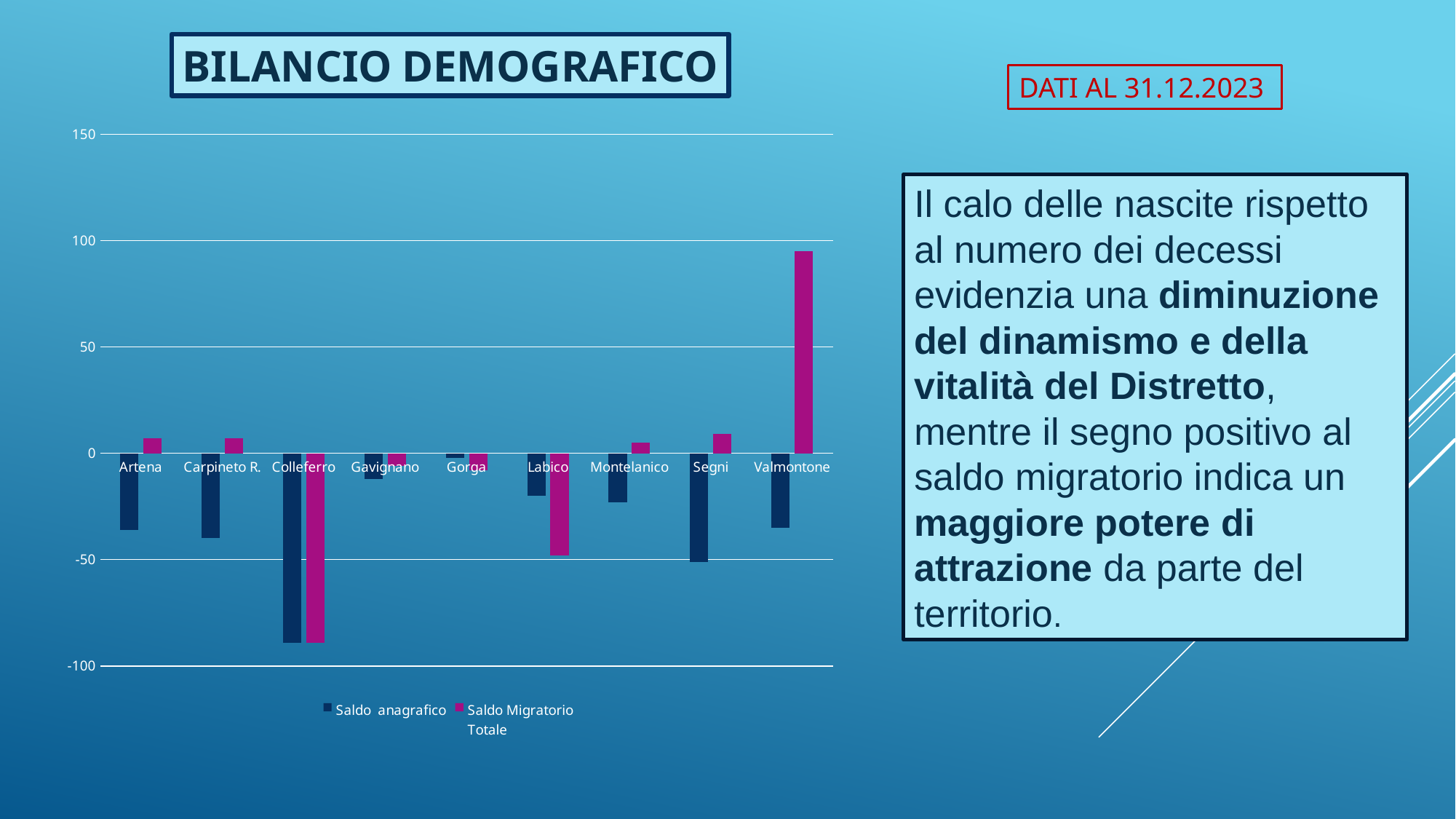
Which municipality has the highest Saldo Migratorio Totale? Valmontone Is the Saldo Migratorio Totale for Valmontone greater or less than 50? greater Which municipality has the lowest Saldo anagrafico? Colleferro Which is larger, the Saldo Migratorio Totale for Labico or for Colleferro? Labico How many series does the chart legend list? 2 How many municipalities (categories) are shown on the x axis of the chart? 9 Which municipality has the lowest Saldo Migratorio Totale? Colleferro Which is larger, the Saldo Migratorio Totale for Valmontone or for Segni? Valmontone Is the Saldo anagrafico for Colleferro greater or less than -50? less Is the Saldo anagrafico for Artena greater or less than -50? greater What is the title of the chart on the slide? BILANCIO DEMOGRAFICO What kind of chart is shown on the slide? bar chart